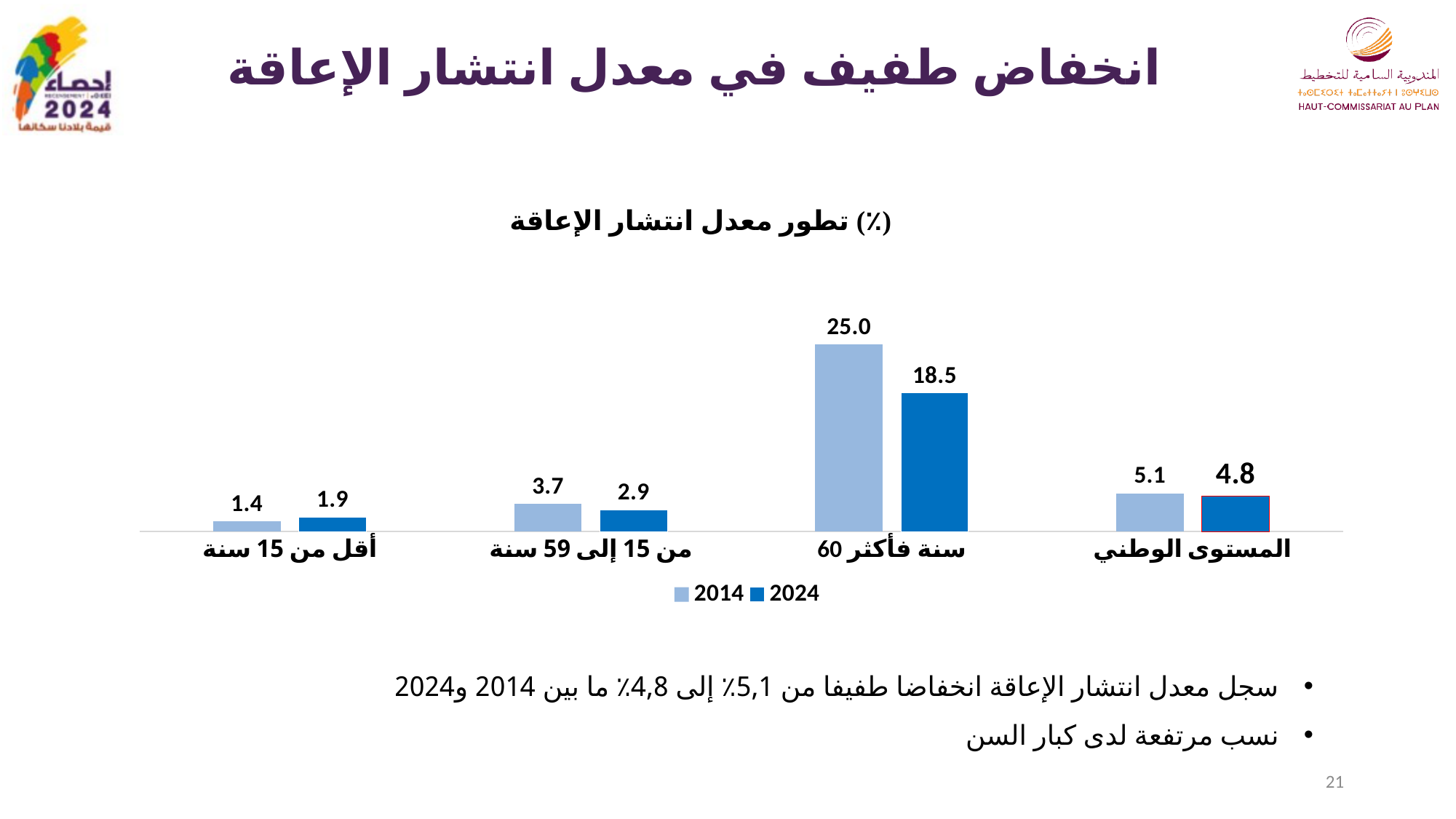
What is the value for 2014 in the category "من 15 إلى 59 سنة"? 3.7 What is the value for 2024 in the category "60 سنة فأكثر"? 18.5 What is the value for 2014 in the category "المستوى الوطني"? 5.1 What is the difference between the 2014 and 2024 values for "المستوى الوطني"? 0.3 What is the difference between the 2014 and 2024 values for "60 سنة فأكثر"? 6.5 How many series does the legend list? 2 What kind of chart is shown on the slide? Bar chart How many categories are shown on the x axis? 4 Which category has the highest value for 2014? 60 سنة فأكثر What is the value for 2024 in the category "أقل من 15 سنة"? 1.9 Which category has the lowest value for 2024? أقل من 15 سنة For the category "أقل من 15 سنة", which is larger: the 2014 value or the 2024 value? 2024